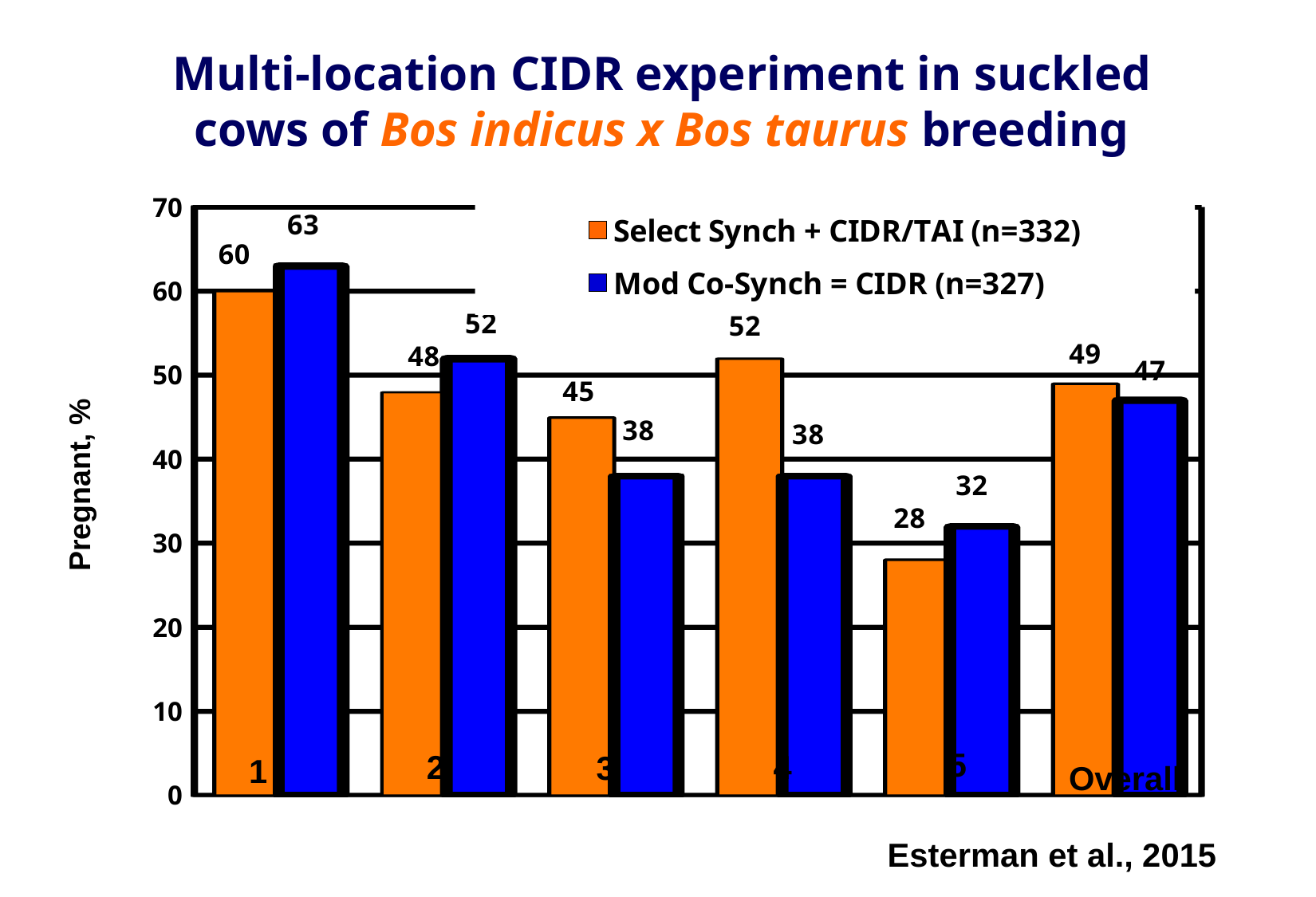
At which location is the Select Synch + CIDR/TAI pregnancy rate lowest? 5 What is the difference between the Mod Co-Synch = CIDR and Select Synch + CIDR/TAI pregnancy rates at location 3? 7 What is the label of the y axis? Pregnant, % At location 4, which treatment has the higher pregnancy rate? Select Synch + CIDR/TAI How many categories are shown on the x axis? 6 How many series does the legend list? 2 What is the Overall pregnancy rate for Mod Co-Synch = CIDR? 47 At which location is the Mod Co-Synch = CIDR pregnancy rate highest? 1 What kind of chart is shown on the slide? bar chart What is the pregnancy rate for Mod Co-Synch = CIDR at location 5? 32 Is the Select Synch + CIDR/TAI value at location 5 greater or less than 30? less What is the pregnancy rate for Select Synch + CIDR/TAI at location 1? 60